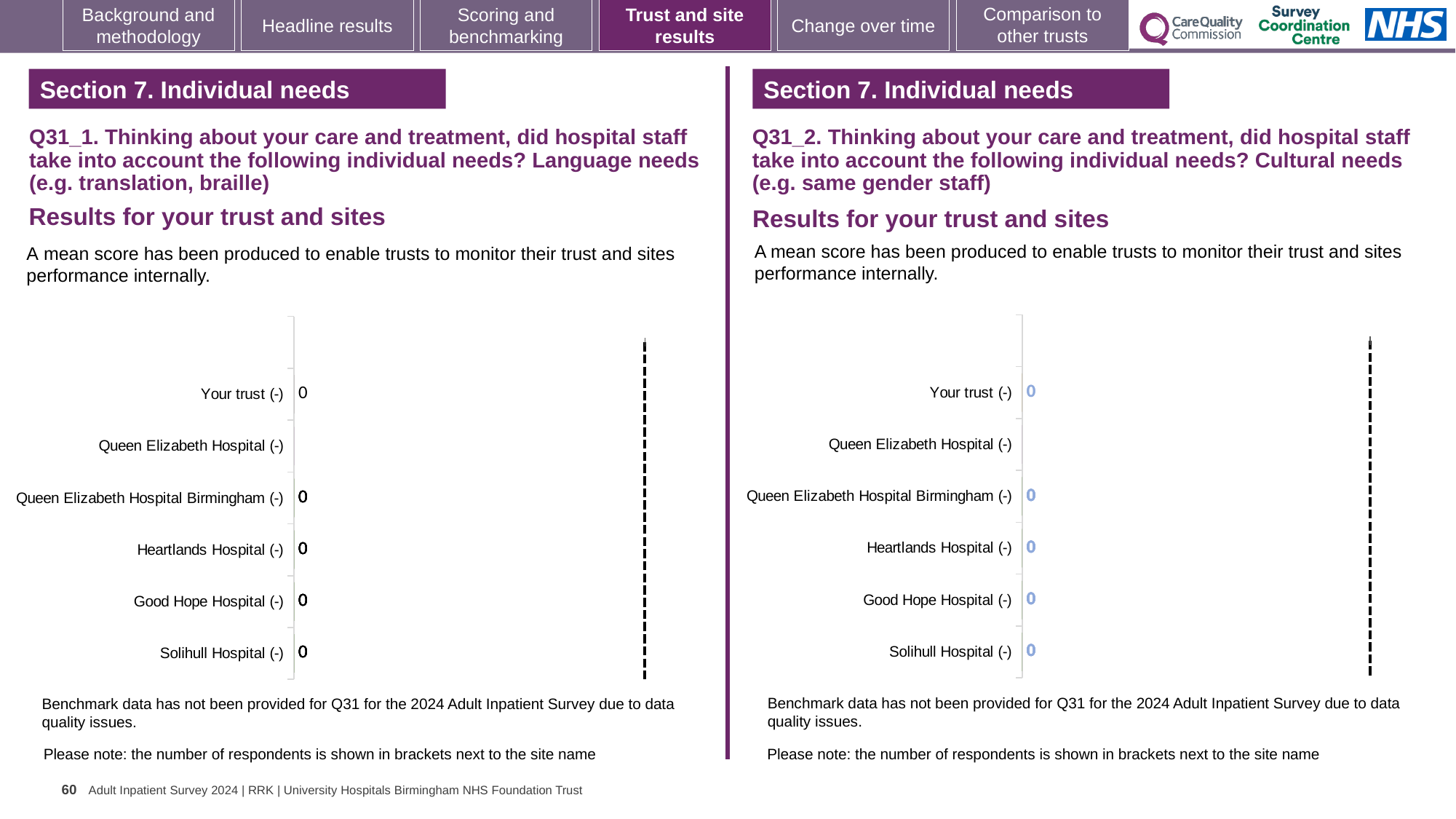
On the left chart (Q31_1, Language needs), what is the value shown for Your trust? 0 On the right chart (Q31_2, Cultural needs), what is the value shown for Good Hope Hospital? 0 On the right chart (Q31_2, Cultural needs), what is the value shown for Your trust? 0 On the left chart (Q31_1, Language needs), what is the difference between the values for Heartlands Hospital and Good Hope Hospital? 0 How many categories are listed on the left chart (Q31_1, Language needs)? 6 On the right chart (Q31_2, Cultural needs), which category is listed first at the top? Your trust (-) According to the note below the left chart, why has benchmark data not been provided for Q31? Due to data quality issues On the left chart (Q31_1, Language needs), what is the value shown for Heartlands Hospital? 0 What kind of chart is the left chart (Q31_1, Language needs)? Bar chart On the right chart (Q31_2, Cultural needs), what is the value shown for Queen Elizabeth Hospital Birmingham? 0 How many categories are listed on the right chart (Q31_2, Cultural needs)? 6 On the left chart (Q31_1, Language needs), what is the value shown for Solihull Hospital? 0